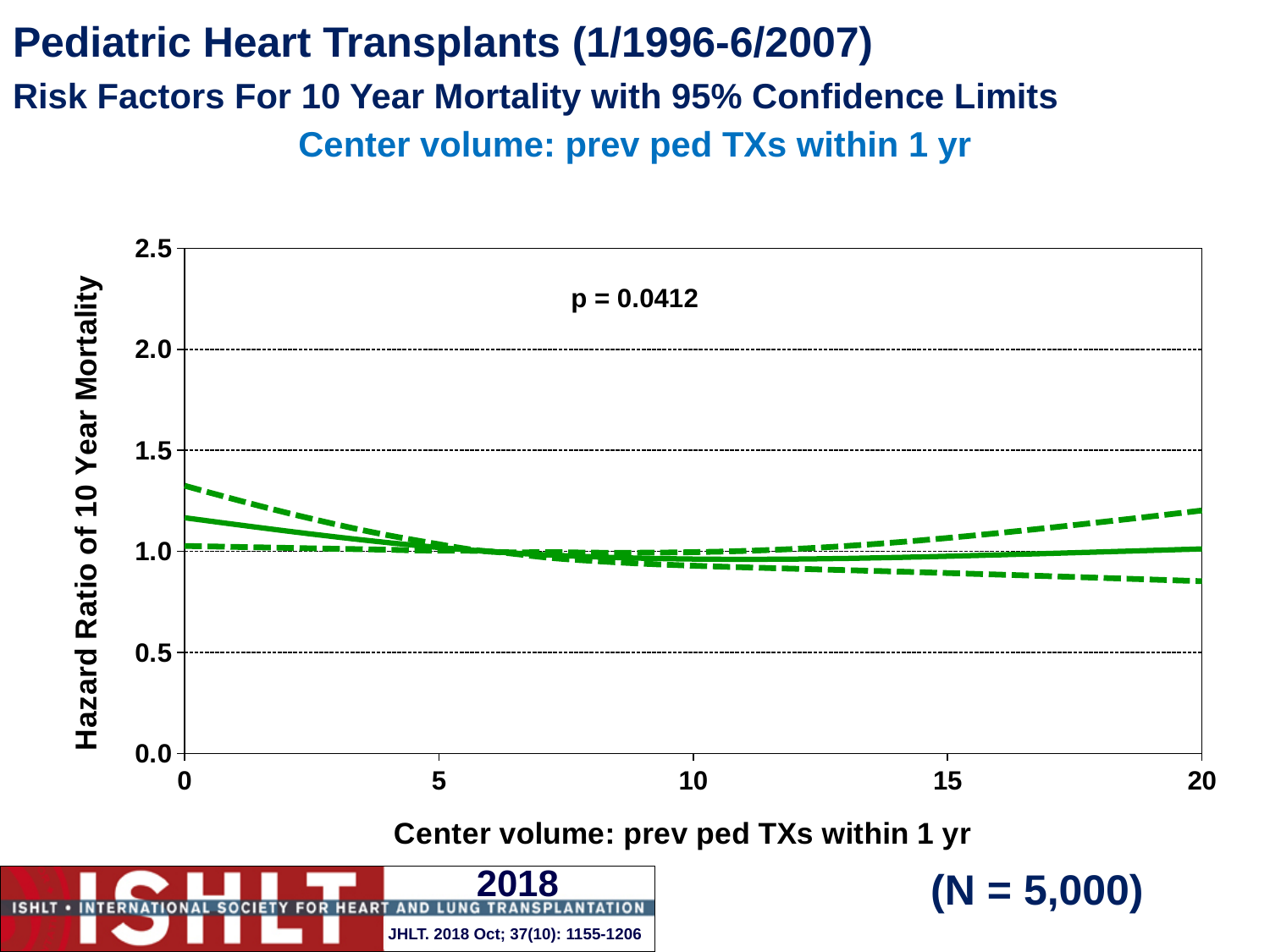
Is the value of the upper dashed confidence limit at a center volume of 20 greater or less than 1.0? greater How many lines are plotted on the chart? 3 Does the upper dashed confidence limit rise or fall between a center volume of 10 and a center volume of 20? rise Is the value of the lower dashed confidence limit at a center volume of 20 greater or less than 1.0? less Which is larger at a center volume of 0: the solid hazard ratio line or the lower dashed confidence limit? the solid hazard ratio line Is the value of the upper dashed confidence limit at a center volume of 0 greater or less than 1.5? less Does the solid hazard ratio line rise or fall between a center volume of 0 and a center volume of 10? fall What sample size (N) is shown on the slide? N = 5,000 What kind of chart is shown on the slide? line chart What p-value is printed on the chart? p = 0.0412